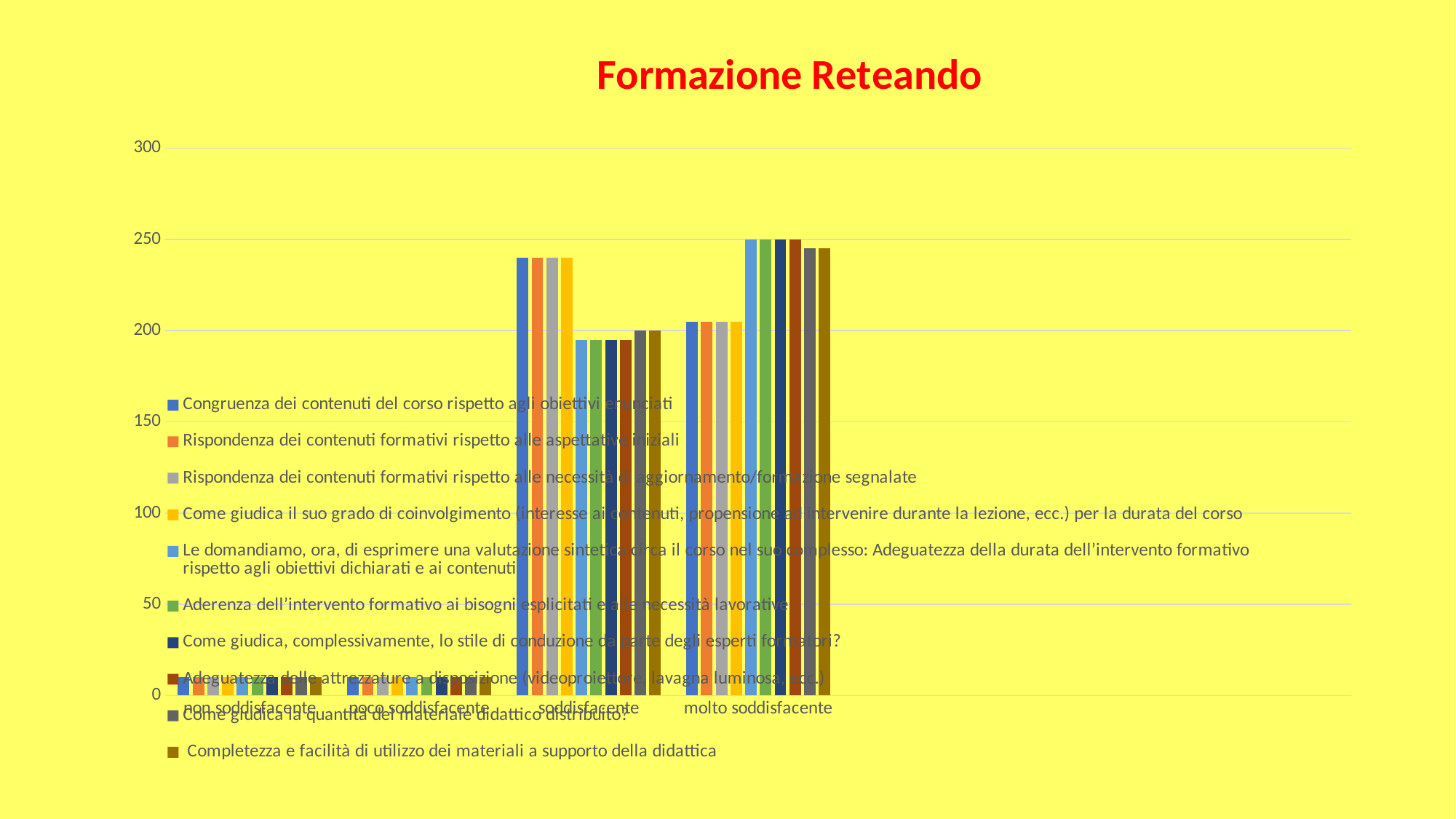
How many series does the chart legend list? 10 What kind of chart is shown on the slide? bar chart Which category has the highest value for the series 'Congruenza dei contenuti del corso rispetto agli obiettivi enunciati'? soddisfacente For the series 'Aderenza dell'intervento formativo ai bisogni esplicitati e alle necessità lavorative', which category has the larger value: 'soddisfacente' or 'molto soddisfacente'? molto soddisfacente What is the title of the chart? Formazione Reteando For the series 'Congruenza dei contenuti del corso rispetto agli obiettivi enunciati', which category has the larger value: 'soddisfacente' or 'molto soddisfacente'? soddisfacente Is the value for 'soddisfacente' in the series 'Congruenza dei contenuti del corso rispetto agli obiettivi enunciati' greater or less than 200? greater Which category has the highest value for the series 'Come giudica, complessivamente, lo stile di conduzione da parte degli esperti formatori?'? molto soddisfacente Is the value for 'molto soddisfacente' in the series 'Aderenza dell'intervento formativo ai bisogni esplicitati e alle necessità lavorative' greater or less than 200? greater Is the value for 'non soddisfacente' in the series 'Congruenza dei contenuti del corso rispetto agli obiettivi enunciati' greater or less than 50? less How many categories are shown along the x axis of the chart? 4